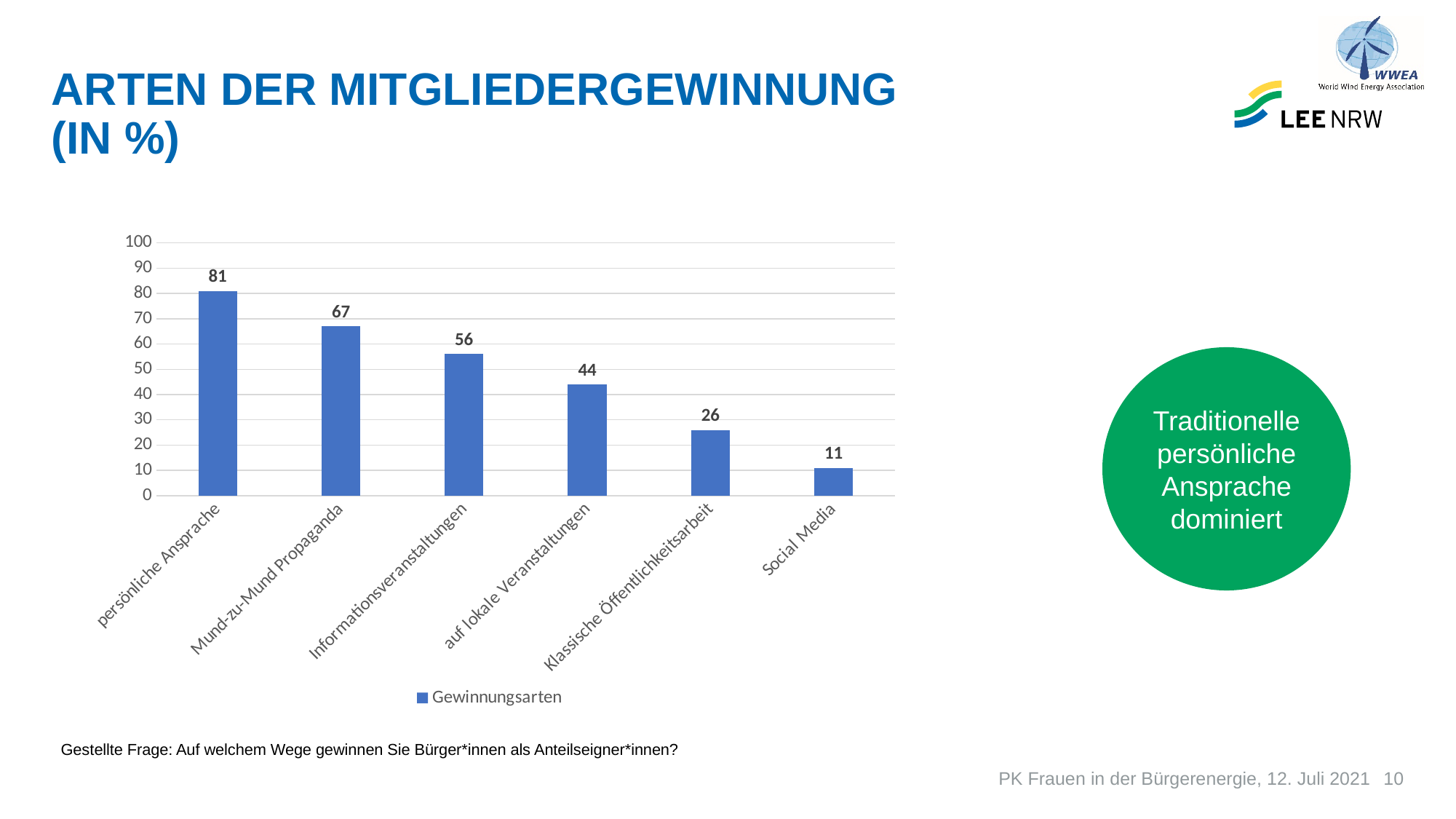
Which category has the highest value? persönliche Ansprache What is the difference between Mund-zu-Mund Propaganda and auf lokale Veranstaltungen? 23 How many categories are shown in the chart? 6 What is the value for persönliche Ansprache? 81 How many series does the legend list? 1 Is the value for Klassische Öffentlichkeitsarbeit greater or less than 30? less What is the value for Informationsveranstaltungen? 56 Which is larger, Klassische Öffentlichkeitsarbeit or Informationsveranstaltungen? Informationsveranstaltungen Do the values rise or fall from left to right along the x axis? fall What kind of chart is shown? bar chart Which category has the lowest value? Social Media What is the value for Social Media? 11